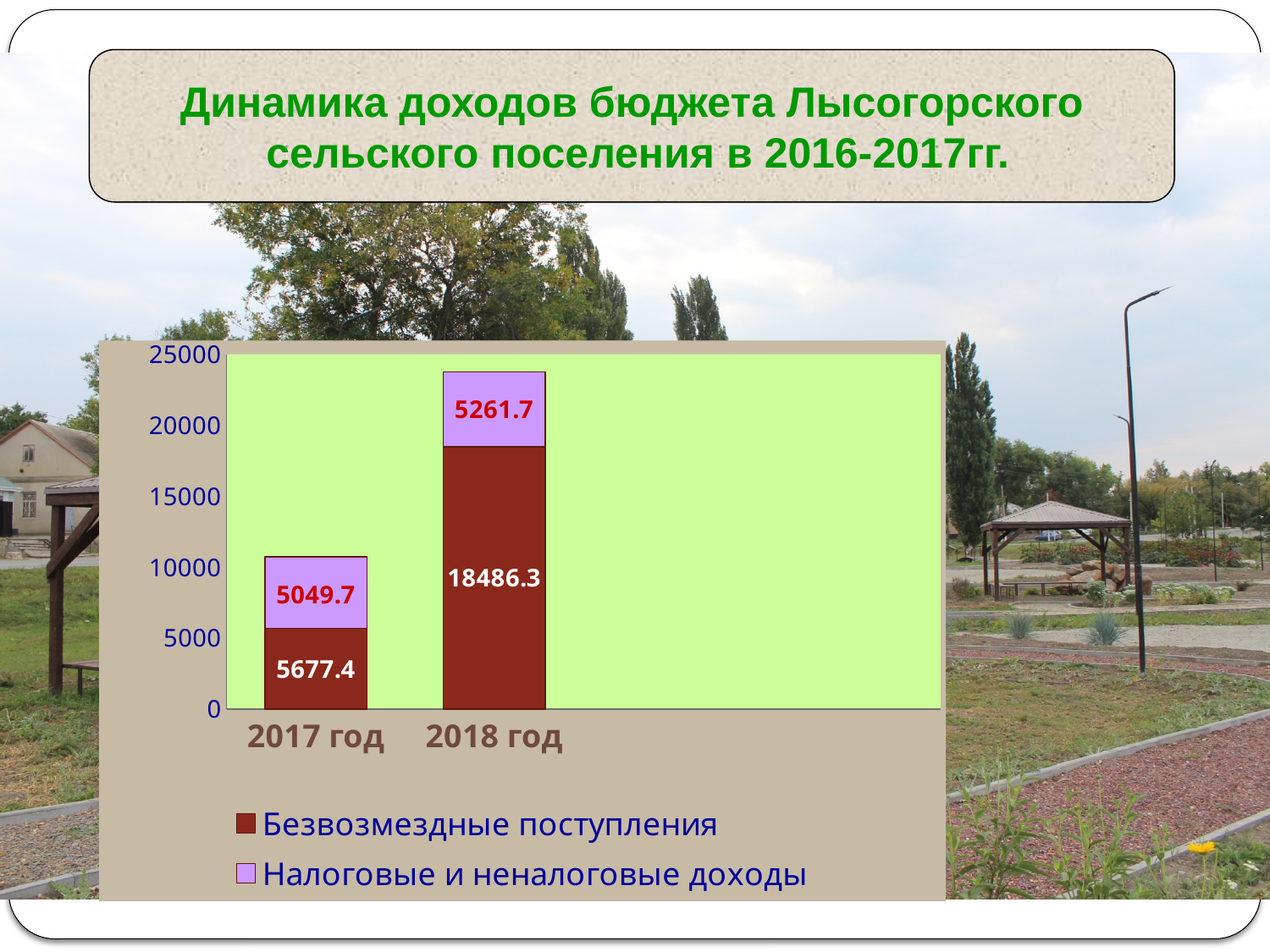
What is the value of Безвозмездные поступления for 2017 год? 5677.4 How many series does the legend list? 2 What kind of chart is shown on the slide? Stacked bar chart By how much did Безвозмездные поступления increase from 2017 год to 2018 год? 12808.9 What is the value of Налоговые и неналоговые доходы for 2017 год? 5049.7 Which legend entry is shown in dark red? Безвозмездные поступления Which year has the larger value for Безвозмездные поступления, 2017 год or 2018 год? 2018 год What is the value of Безвозмездные поступления for 2018 год? 18486.3 What is the value of Налоговые и неналоговые доходы for 2018 год? 5261.7 What is the total of the stacked bar for 2018 год? 23748.0 What is the total of the stacked bar for 2017 год? 10727.1 What is the difference between Налоговые и неналоговые доходы in 2018 год and 2017 год? 212.0